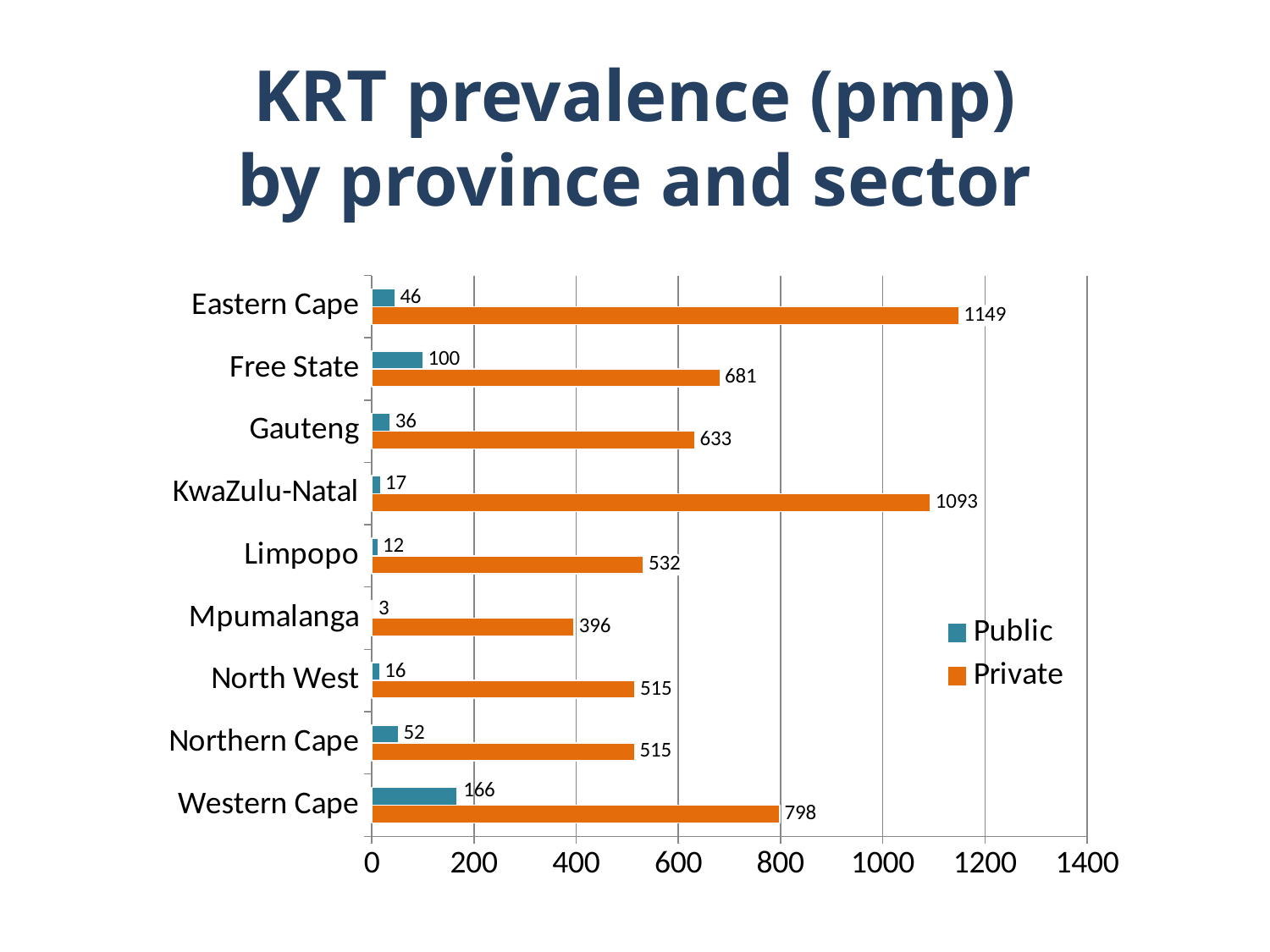
Is the Private value for KwaZulu-Natal greater or less than 1000? greater Which province has the highest Private KRT prevalence? Eastern Cape Which is larger, the Private value for Gauteng or the Private value for Free State? Free State How many series does the legend list? 2 What kind of chart is shown on the slide? bar chart What is the difference between the Private and Public values for Free State? 581 What is the Public value for Mpumalanga? 3 What is the Private KRT prevalence for Eastern Cape? 1149 How many provinces are shown on the chart? 9 Which province has the lowest Public KRT prevalence? Mpumalanga What is the Public KRT prevalence for Western Cape? 166 Which province has the lowest Private KRT prevalence? Mpumalanga